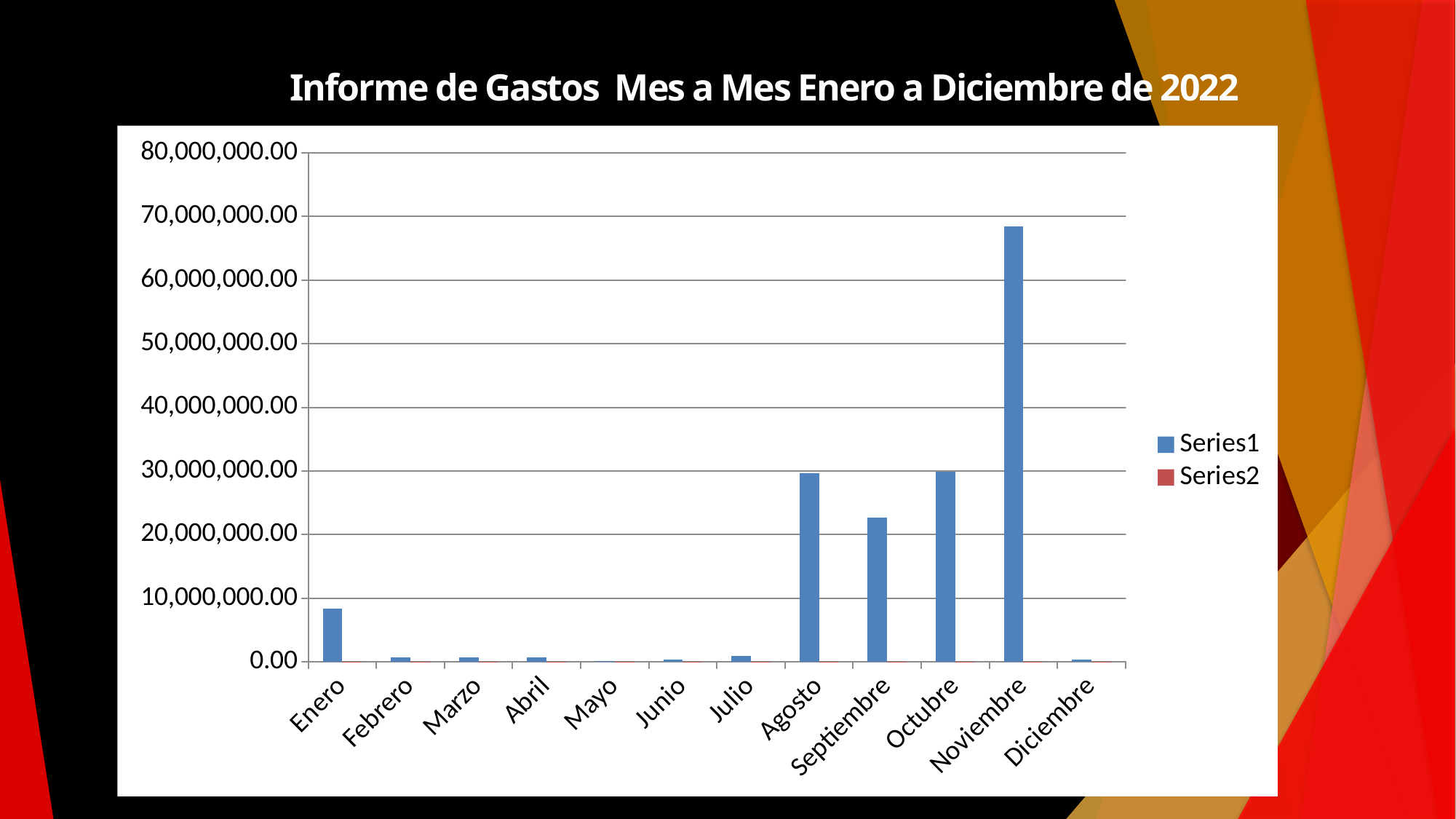
What is the title of the chart? Informe de Gastos Mes a Mes Enero a Diciembre de 2022 How many categories (months) are shown on the x axis? 12 How many series does the legend list? 2 Which month has the highest value? Noviembre Is the value for Noviembre greater or less than 60,000,000.00? greater Which is larger, the value for Octubre or the value for Noviembre? Noviembre Is the value for Septiembre greater or less than 20,000,000.00? greater Which is larger, the value for Enero or the value for Febrero? Enero Is the value for Enero greater or less than 10,000,000.00? less Which is larger, the value for Agosto or the value for Septiembre? Agosto What kind of chart is shown on the slide? Bar chart